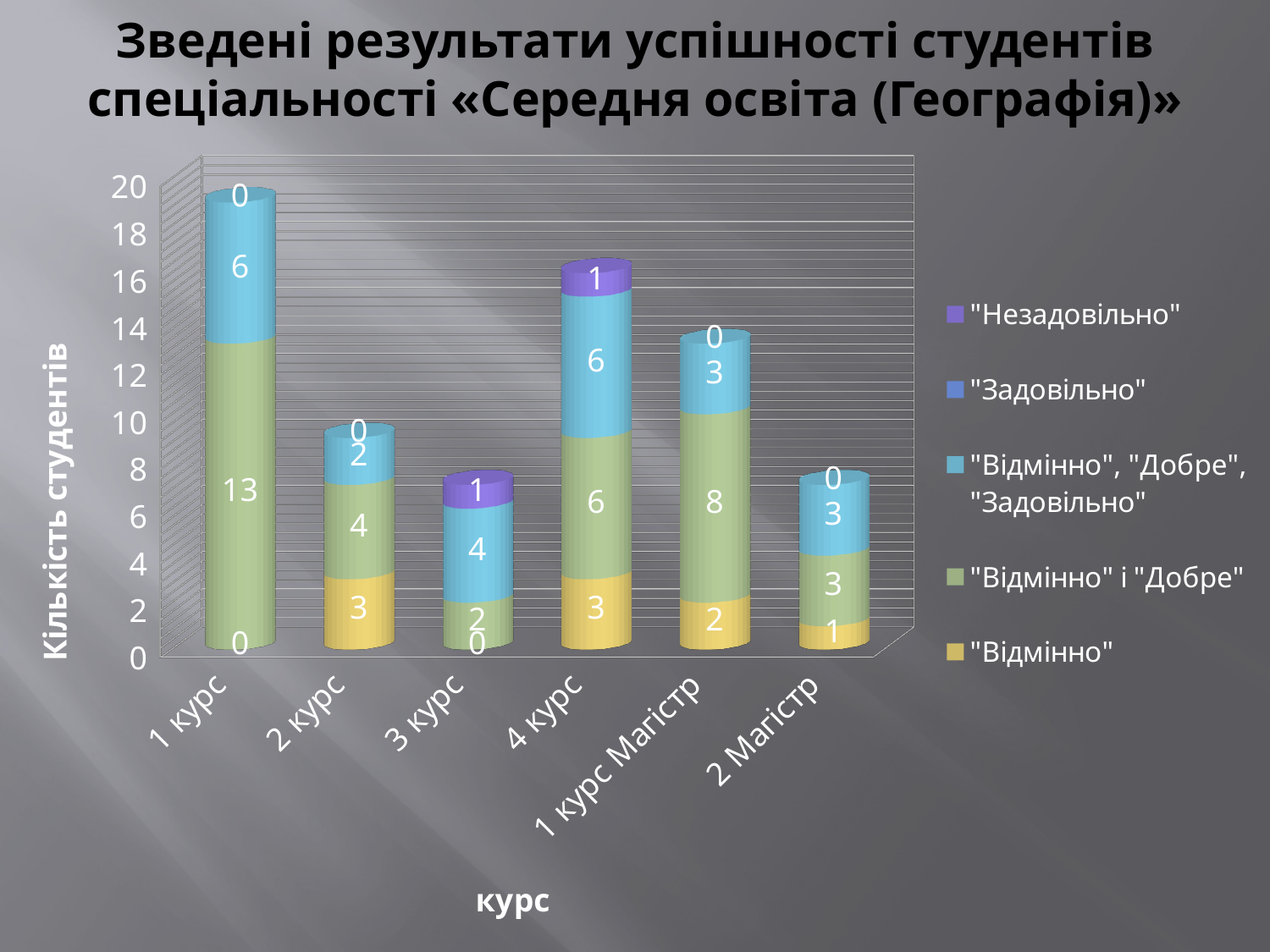
What is the total of the stacked bar for 4 курс? 16 What is the value of "Відмінно" і "Добре" for 1 курс? 13 What is the value of "Відмінно", "Добре", "Задовільно" for 4 курс? 6 How many series does the legend list? 5 What is the value of "Відмінно" for 2 курс? 3 What is the value of "Відмінно" і "Добре" for 1 курс Магістр? 8 Which course has the tallest stacked bar? 1 курс How many courses are shown on the x axis? 6 What is the value of "Відмінно" for 2 Магістр? 1 What kind of chart is shown on the slide? Stacked bar chart Which is larger: the "Відмінно" value for 4 курс or for 1 курс Магістр? 4 курс What is the difference between the "Відмінно" і "Добре" values for 1 курс and 1 курс Магістр? 5